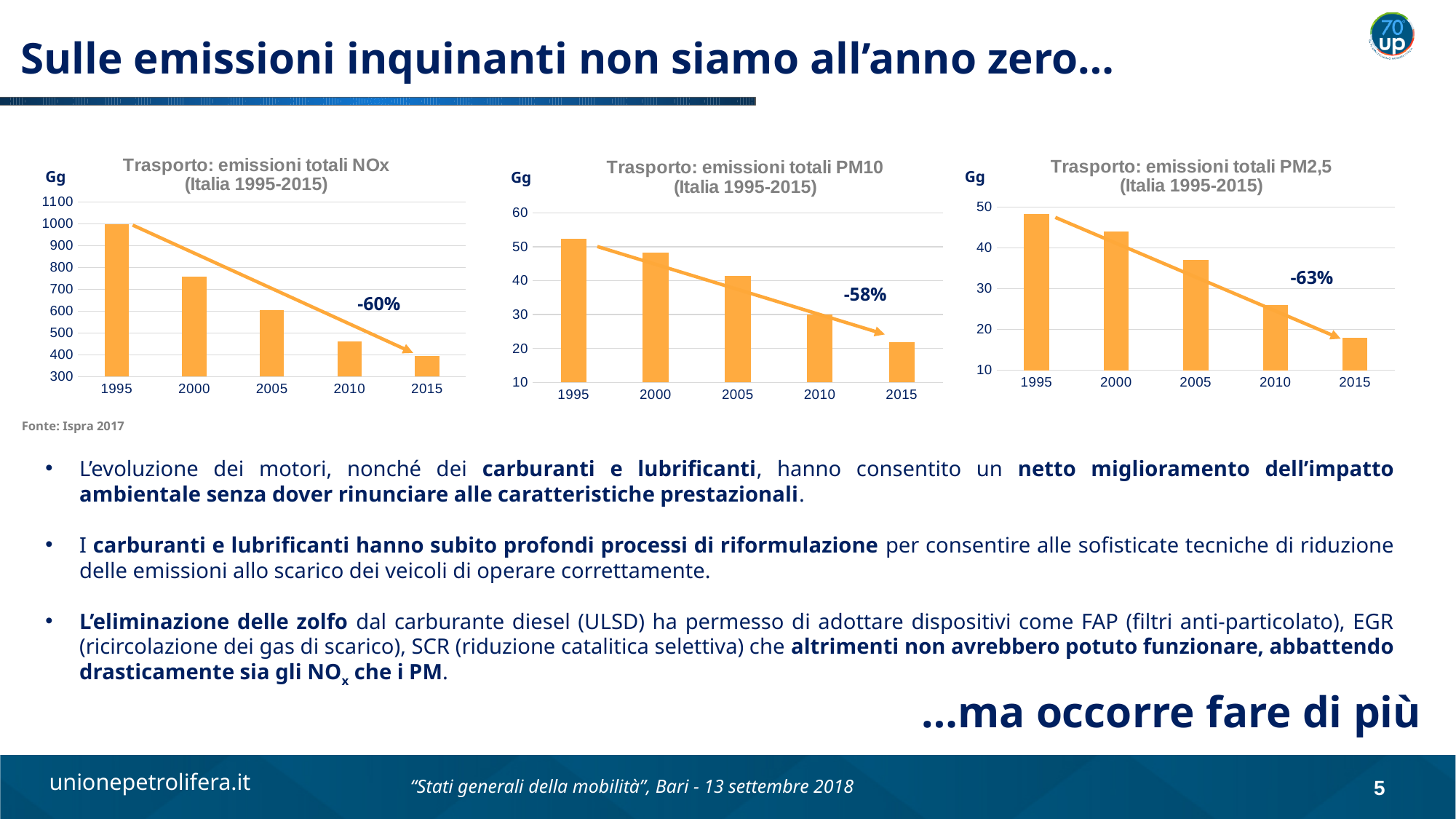
How many years are shown on the x axis of the 'Trasporto: emissioni totali PM10' chart? 5 In the 'Trasporto: emissioni totali NOx' chart, is the value for 2000 greater or less than 700? greater In the 'Trasporto: emissioni totali NOx' chart, is the value for 2010 greater or less than 500? less What percentage change is annotated on the 'Trasporto: emissioni totali PM10' chart? -58% In the 'Trasporto: emissioni totali NOx' chart, which year has the highest value? 1995 In the 'Trasporto: emissioni totali PM10' chart, is the value for 1995 greater or less than 50? greater In the 'Trasporto: emissioni totali PM10' chart, do the values rise or fall from 1995 to 2015? fall What kind of chart is the 'Trasporto: emissioni totali NOx' chart? bar chart What percentage change is annotated on the 'Trasporto: emissioni totali NOx' chart? -60% In the 'Trasporto: emissioni totali PM2,5' chart, which is larger, the value for 2000 or the value for 2010? 2000 In the 'Trasporto: emissioni totali NOx' chart, which year has the lowest value? 2015